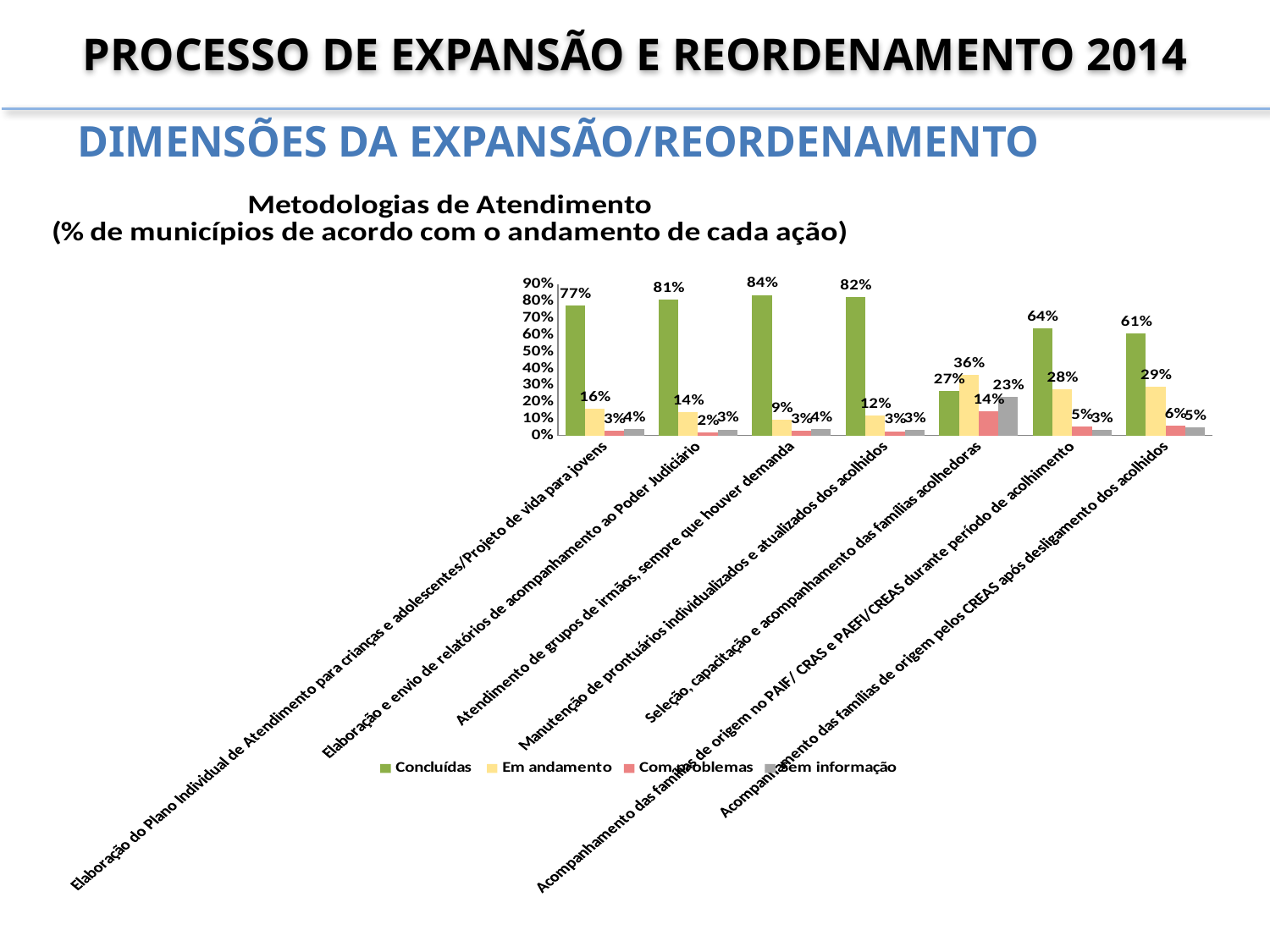
What type of chart is shown on the slide? bar chart What is the difference between the 'Concluídas' values for 'Elaboração e envio de relatórios de acompanhamento ao Poder Judiciário' (81%) and 'Acompanhamento das famílias de origem pelos CREAS após desligamento dos acolhidos' (61%)? 20% What is the 'Sem informação' value for 'Seleção, capacitação e acompanhamento das famílias acolhedoras'? 23% Which category has the lowest 'Concluídas' value? Seleção, capacitação e acompanhamento das famílias acolhedoras What is the title of the chart? Metodologias de Atendimento (% de municípios de acordo com o andamento de cada ação) Is the 'Concluídas' value for 'Manutenção de prontuários individualizados e atualizados dos acolhidos' greater or less than 80%? greater What is the 'Em andamento' value for 'Seleção, capacitação e acompanhamento das famílias acolhedoras'? 36% How many categories (actions) are plotted on the x axis? 7 Which is larger: the 'Em andamento' value for 'Acompanhamento das famílias de origem no PAIF/CRAS e PAEFI/CREAS durante período de acolhimento' or for 'Elaboração do Plano Individual de Atendimento para crianças e adolescentes/Projeto de vida para jovens'? Acompanhamento das famílias de origem no PAIF/CRAS e PAEFI/CREAS durante período de acolhimento How many series does the legend list? 4 What is the 'Concluídas' value for 'Atendimento de grupos de irmãos, sempre que houver demanda'? 84% Which category has the highest 'Concluídas' value? Atendimento de grupos de irmãos, sempre que houver demanda